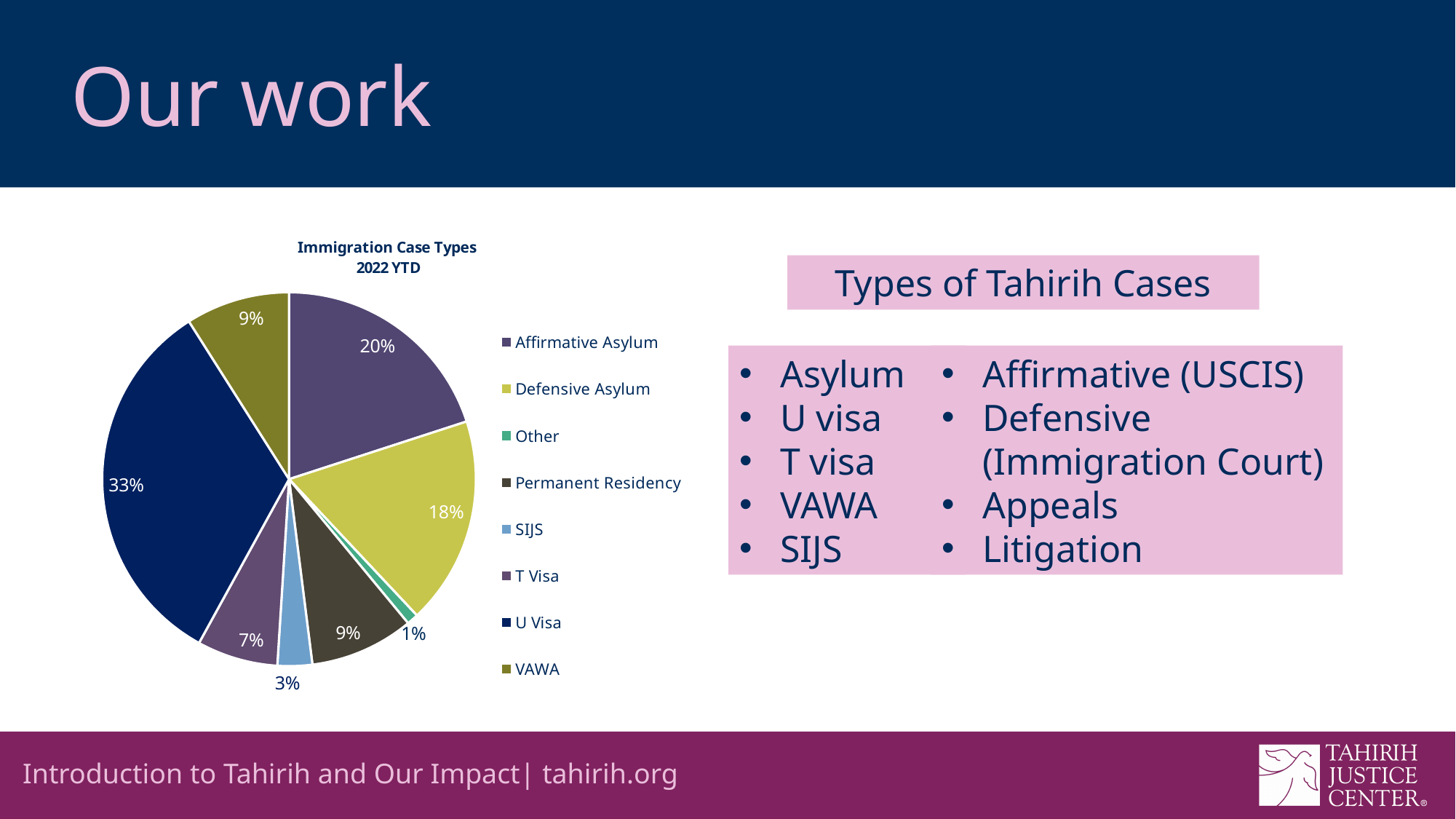
What is the difference in percentage points between U Visa and Affirmative Asylum in the pie chart? 13 What is the title of the chart on the slide? Immigration Case Types 2022 YTD What percentage of cases is Affirmative Asylum in the pie chart? 20% What share of the pie does U Visa represent in the Immigration Case Types 2022 YTD chart? 33% What percentage of cases is SIJS in the pie chart? 3% Which case type has the smallest slice of the pie chart? Other How many case types are shown in the pie chart? 8 What kind of chart is shown on the slide? Pie chart Which case type has the largest slice of the pie chart? U Visa What percentage of cases is T Visa in the pie chart? 7% Which is larger in the pie chart, Affirmative Asylum or Defensive Asylum? Affirmative Asylum What percentage of cases is Defensive Asylum in the pie chart? 18%